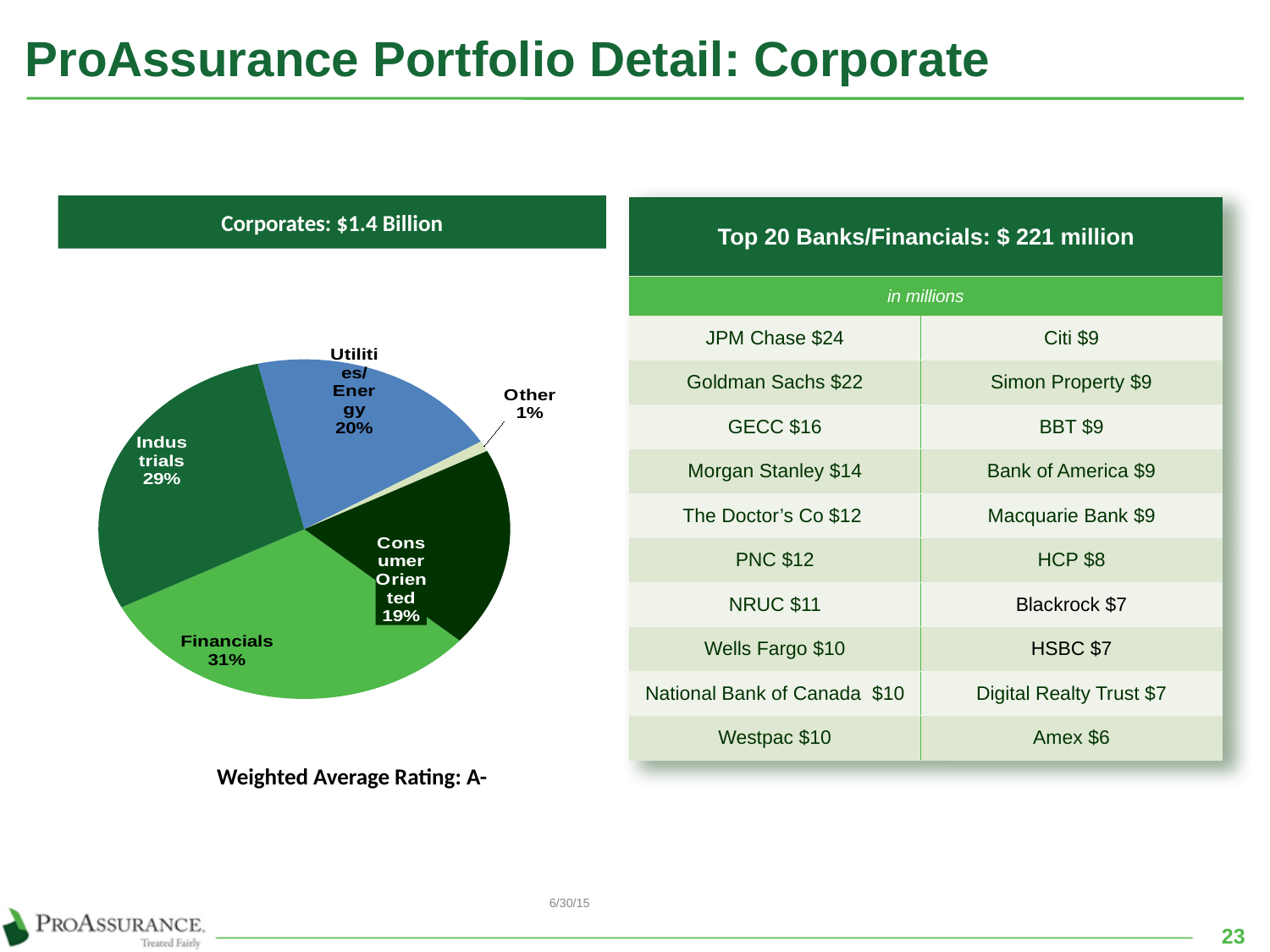
Which slice of the pie chart is the smallest? Other In the pie chart, what share of the corporate portfolio is Financials? 31% In the pie chart, which is larger: Industrials or Utilities/Energy? Industrials In the pie chart, what share of the corporate portfolio is Industrials? 29% How many slices does the pie chart have? 5 In the pie chart, what share of the corporate portfolio is Other? 1% In the pie chart, what share of the corporate portfolio is Utilities/Energy? 20% In the pie chart, what share of the corporate portfolio is Consumer Oriented? 19% In the pie chart, how many percentage points larger is Financials than Consumer Oriented? 12 What kind of chart is shown under the heading "Corporates: $1.4 Billion"? pie chart Which slice of the pie chart is the largest? Financials What is the title shown above the pie chart? Corporates: $1.4 Billion